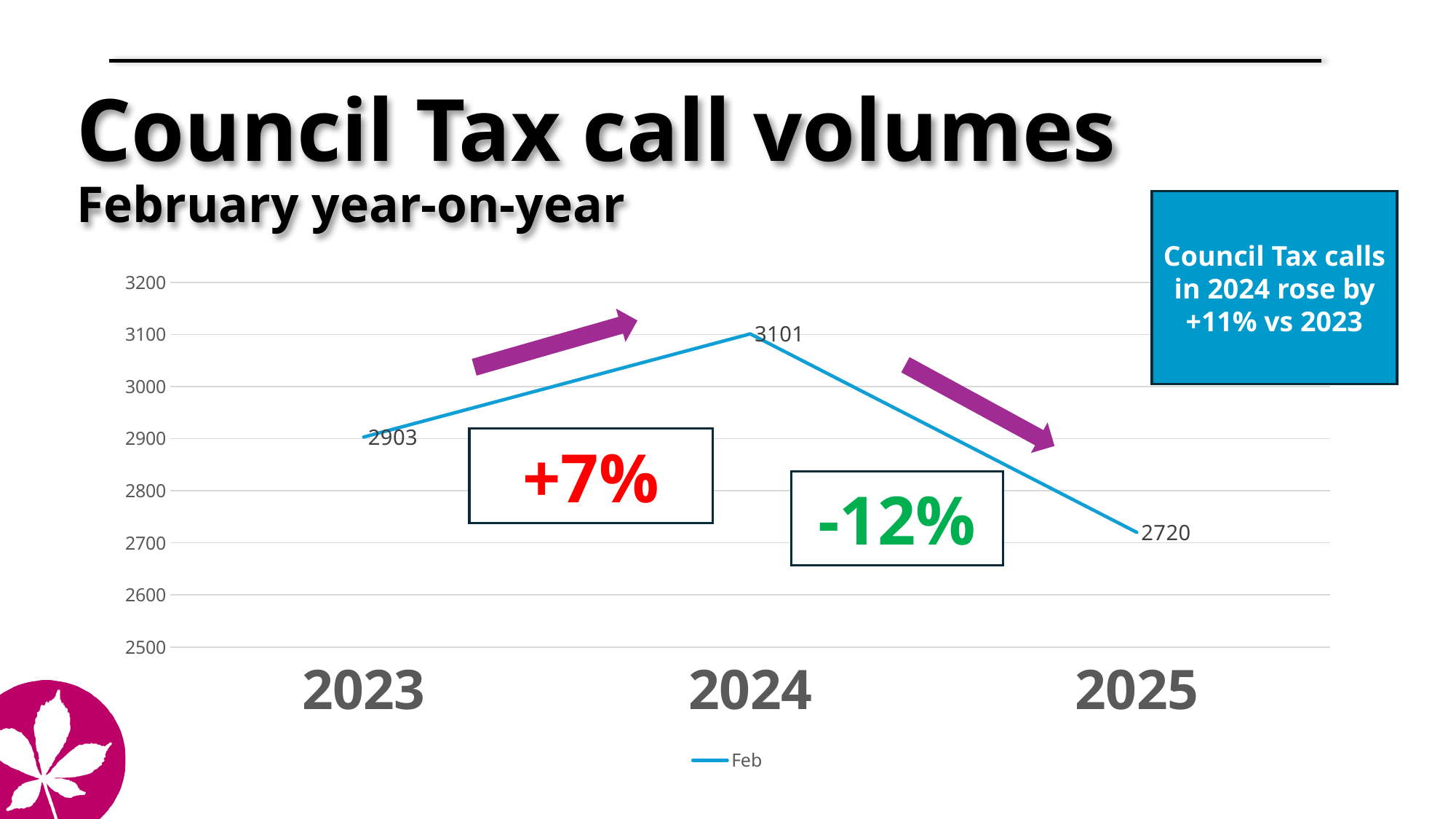
What was the Council Tax call volume in February 2024? 3101 What is the difference between the 2024 and 2025 call volumes? 381 Which year had the highest February call volume? 2024 Which year had more calls, 2023 or 2025? 2023 What is the difference between the 2024 and 2023 call volumes? 198 What is the name of the series shown in the legend? Feb What was the Council Tax call volume in February 2023? 2903 How many years are plotted on the chart? 3 What was the Council Tax call volume in February 2025? 2720 Is the value for 2025 greater or less than 2800? less What type of chart is shown on the slide? line chart Which year had the lowest February call volume? 2025